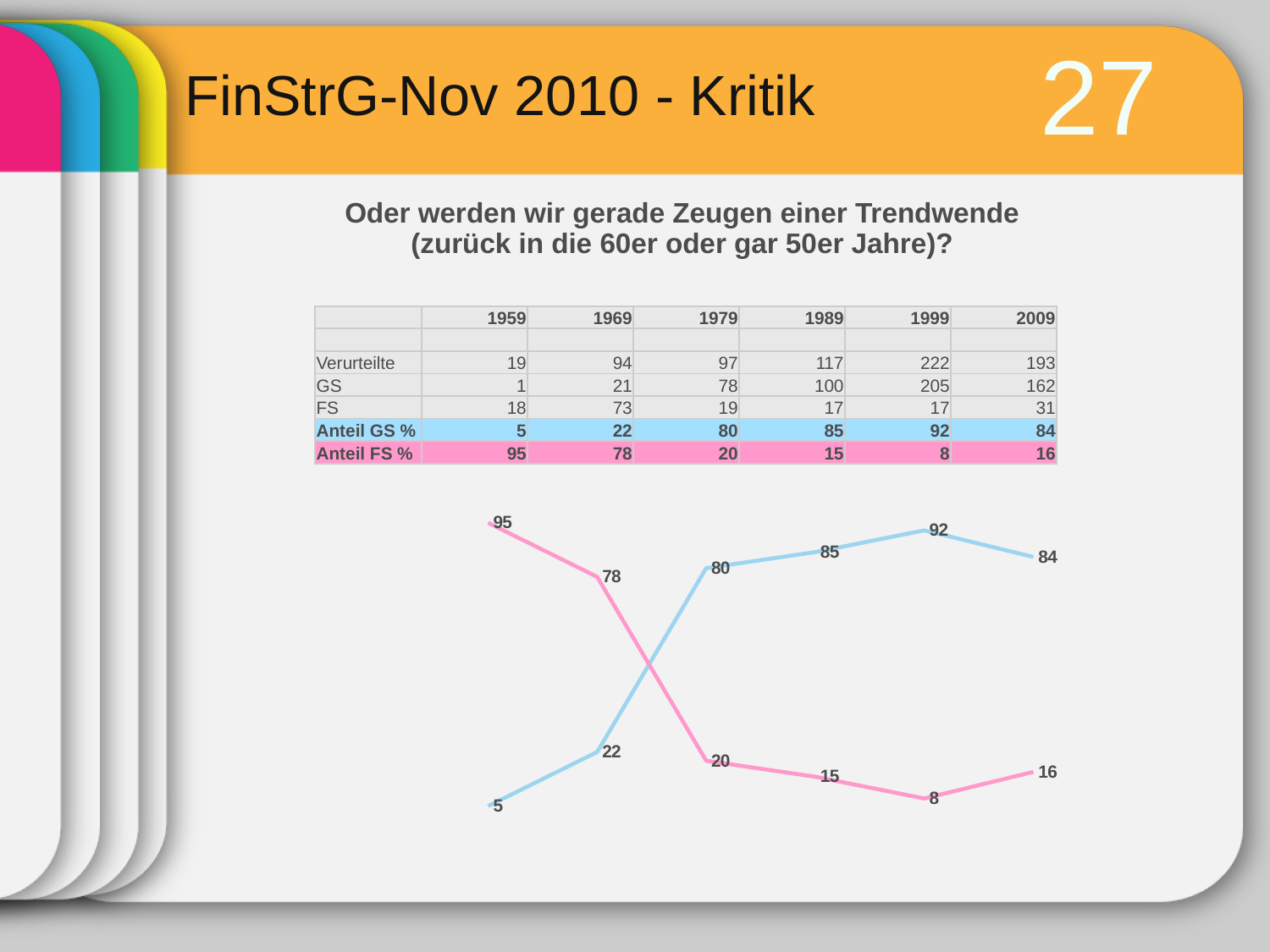
What is the difference between the first and last labelled values on the pink line (95 and 16)? 79 What is the lowest value labelled on the pink line? 8 What is the highest value labelled on the blue line? 92 What is the value of the last point on the blue line (Anteil GS %)? 84 According to the table, which row does the pink line in the chart represent? Anteil FS % Does the blue line generally rise or fall from left to right? rise What kind of chart is shown on the slide? line chart Does the pink line generally rise or fall from left to right? fall How many lines are plotted in the chart? 2 At the third point, which line has the larger value, the blue line (80) or the pink line (20)? blue line What is the value of the first point on the pink line (Anteil FS %)? 95 How many data points does the blue line have? 6